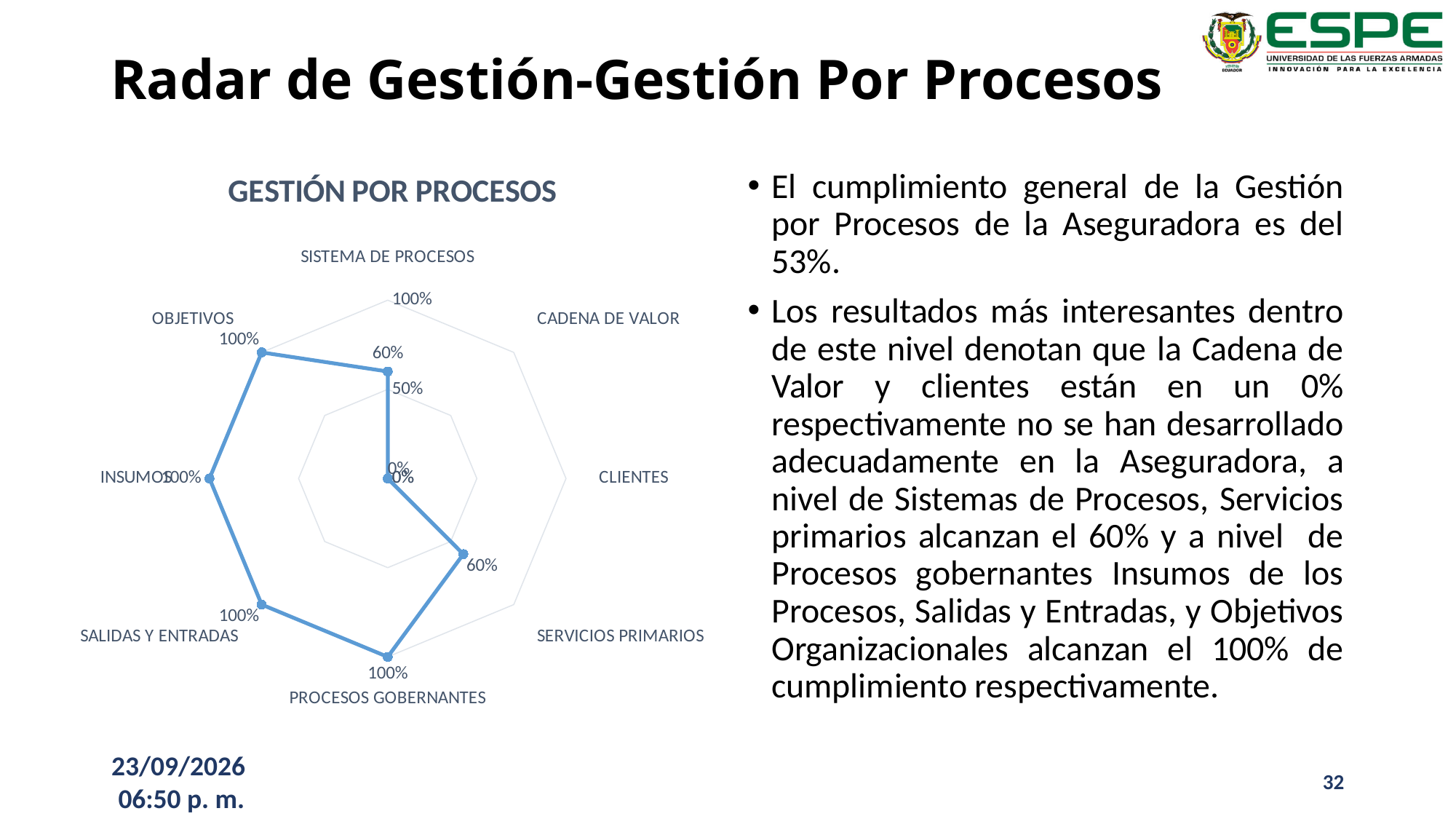
How many categories does the radar chart have? 8 Which category has the lowest value, CLIENTES or SALIDAS Y ENTRADAS? CLIENTES What is the title of the chart? GESTIÓN POR PROCESOS What is the difference between the values for INSUMOS and SISTEMA DE PROCESOS? 40% Is the value for SERVICIOS PRIMARIOS greater or less than 50%? greater What is the value for OBJETIVOS? 100% What is the value for CLIENTES? 0% What is the value for PROCESOS GOBERNANTES? 100% Which is larger, the value for SISTEMA DE PROCESOS or the value for PROCESOS GOBERNANTES? PROCESOS GOBERNANTES What kind of chart is shown on the slide? Radar chart What is the value for SISTEMA DE PROCESOS? 60% What is the value for SERVICIOS PRIMARIOS? 60%